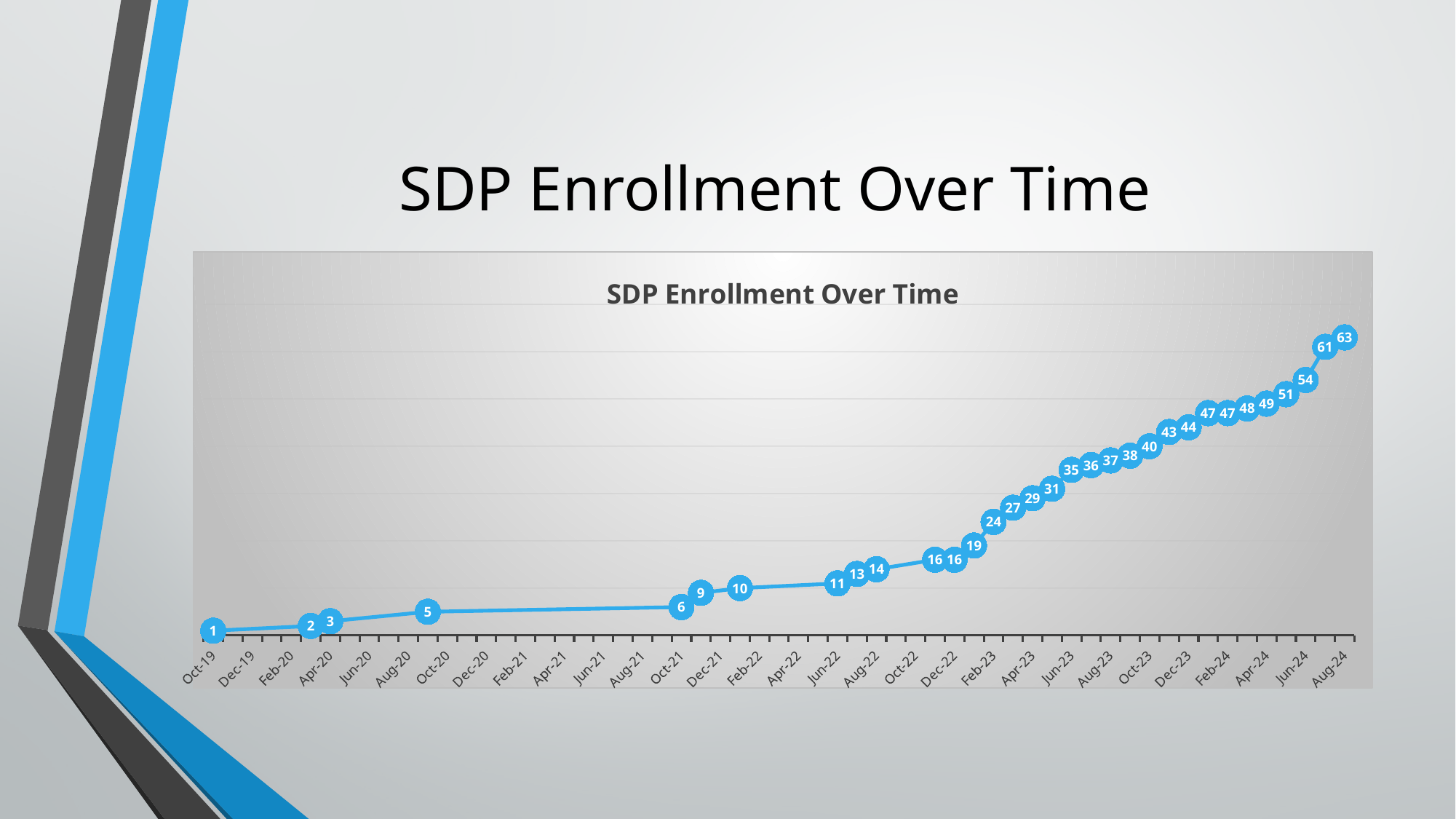
Which date has the lowest SDP enrollment value? Oct-19 What is the SDP enrollment value at Oct-21? 6 What is the difference between the enrollment at Aug-24 and at Oct-19? 62 What is the SDP enrollment value at Jun-24? 54 What is the title of the chart? SDP Enrollment Over Time What is the SDP enrollment value at Oct-19? 1 What is the SDP enrollment value at Oct-23? 40 What is the SDP enrollment value at Aug-24? 63 Which date has the highest SDP enrollment value? Aug-24 What type of chart is shown on the slide? Line chart Do the enrollment values generally rise or fall from Oct-19 to Aug-24? Rise Which is larger, the enrollment at Oct-21 or at Oct-23? Oct-23